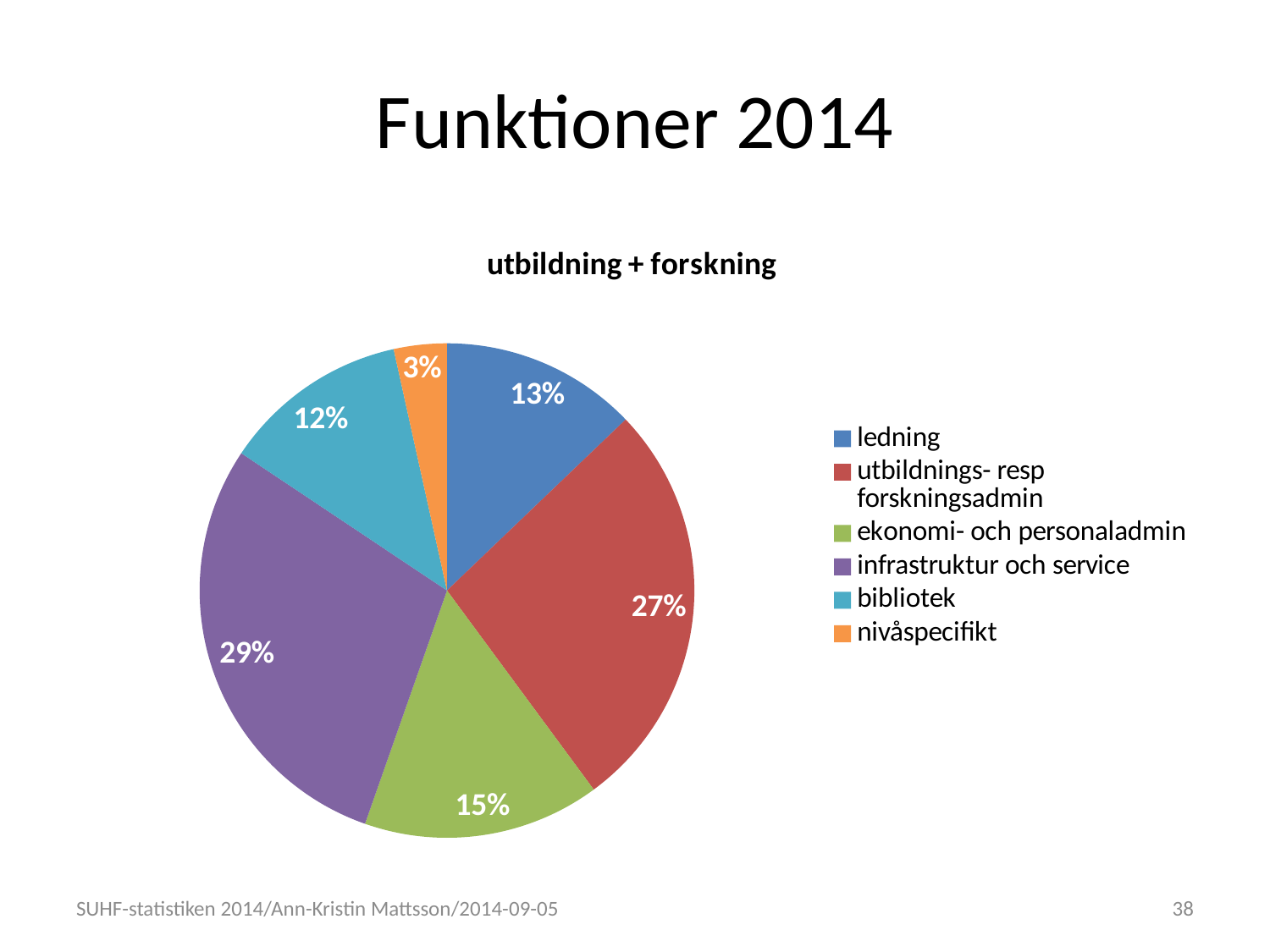
What is the chart's title? utbildning + forskning What share of the pie does bibliotek have? 12% Which is larger, the share for ledning or the share for bibliotek? ledning What colour is the slice for ekonomi- och personaladmin? green What share of the pie does ledning have? 13% Which category has the smallest share of the pie? nivåspecifikt Which category has the largest share of the pie? infrastruktur och service How many categories does the pie chart have? 6 What kind of chart is shown on the slide? pie chart What is the difference in percentage points between utbildnings- resp forskningsadmin and ekonomi- och personaladmin? 12 What share of the pie does infrastruktur och service have? 29% What share of the pie does nivåspecifikt have? 3%